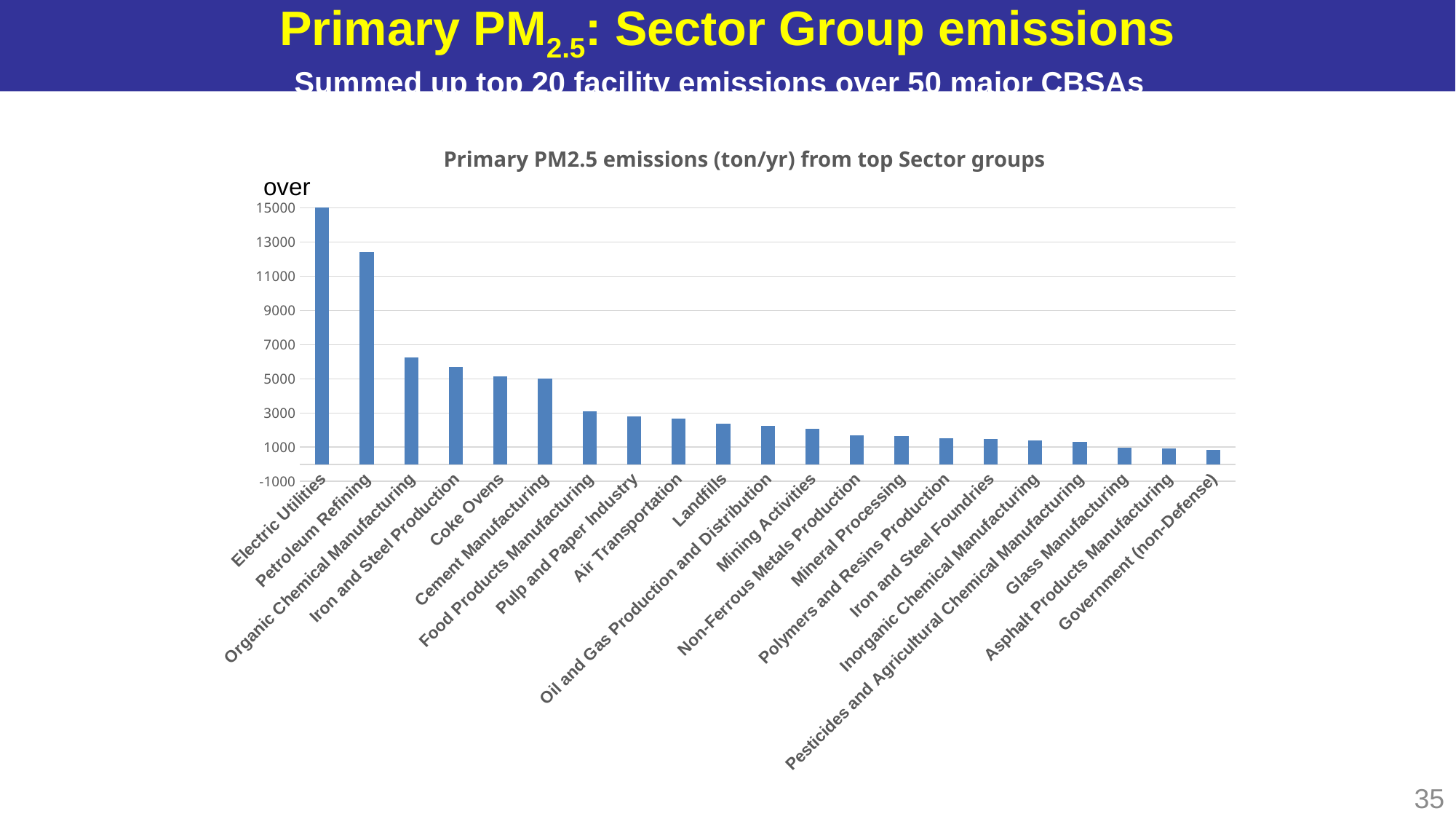
Which has higher emissions, Petroleum Refining or Organic Chemical Manufacturing? Petroleum Refining Which sector group has the highest primary PM2.5 emissions? Electric Utilities Do the bar values rise or fall from left to right along the x axis? fall Is the value for Landfills greater or less than 3000? less Is the value for Electric Utilities greater or less than 13000? greater Is the value for Organic Chemical Manufacturing greater or less than 5000? greater What is the title of the chart? Primary PM2.5 emissions (ton/yr) from top Sector groups What type of chart is shown on the slide? bar chart Which sector group has the lowest primary PM2.5 emissions? Government (non-Defense) How many sector groups are shown on the x axis? 21